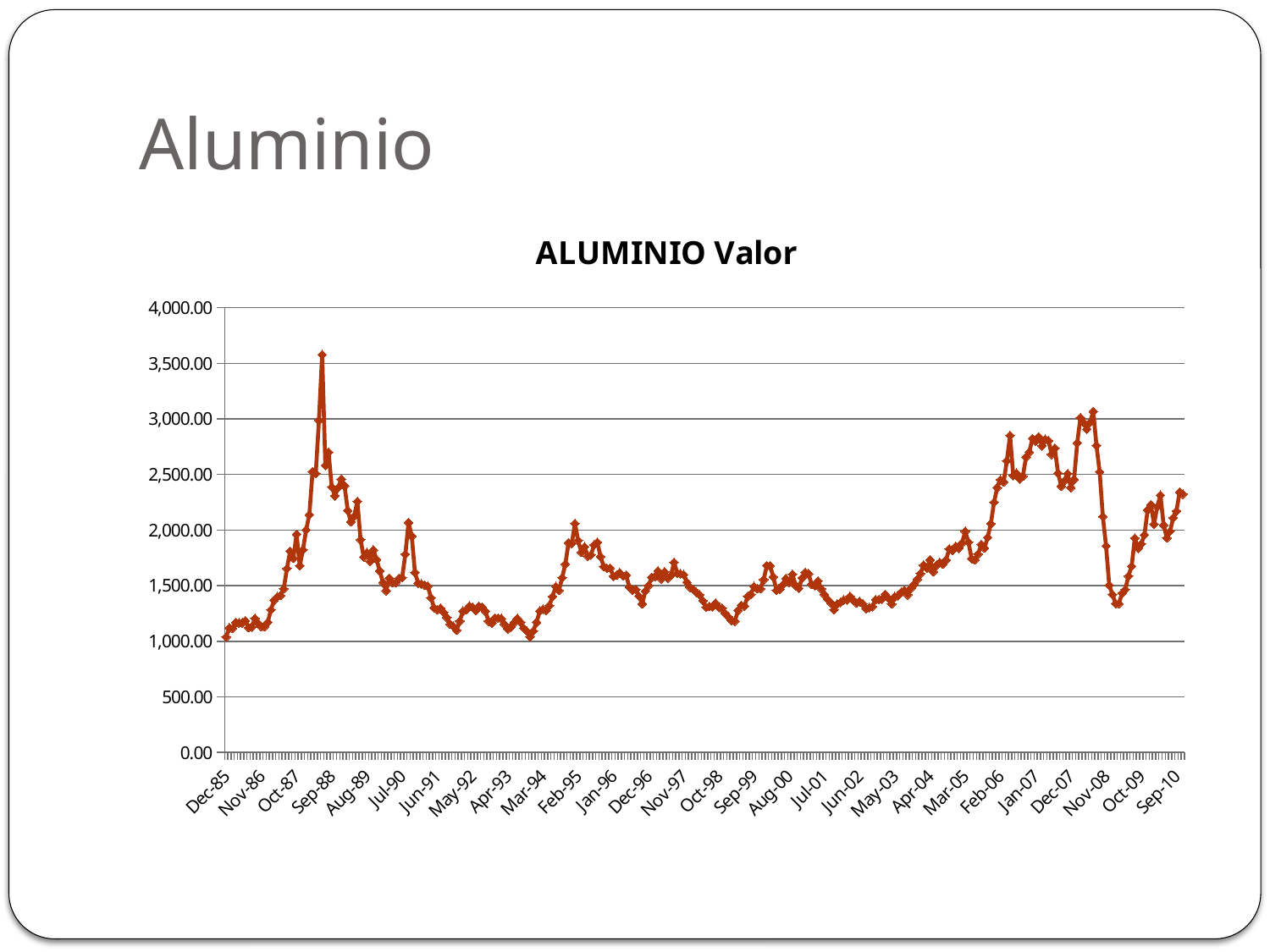
Does the value rise or fall between Sep-88 and Jun-91? fall What is the title of the chart? ALUMINIO Valor What kind of chart is shown on the slide? line chart Is the value for Mar-94 greater or less than 1,500.00? less Is the value for Oct-98 greater or less than 1,500.00? less Is the value for Sep-10 greater or less than 2,000.00? greater Does the value rise or fall between Dec-85 and Sep-88? rise What is the first date label on the x axis of the chart? Dec-85 Which is larger, the value for Jan-07 or the value for Jun-02? Jan-07